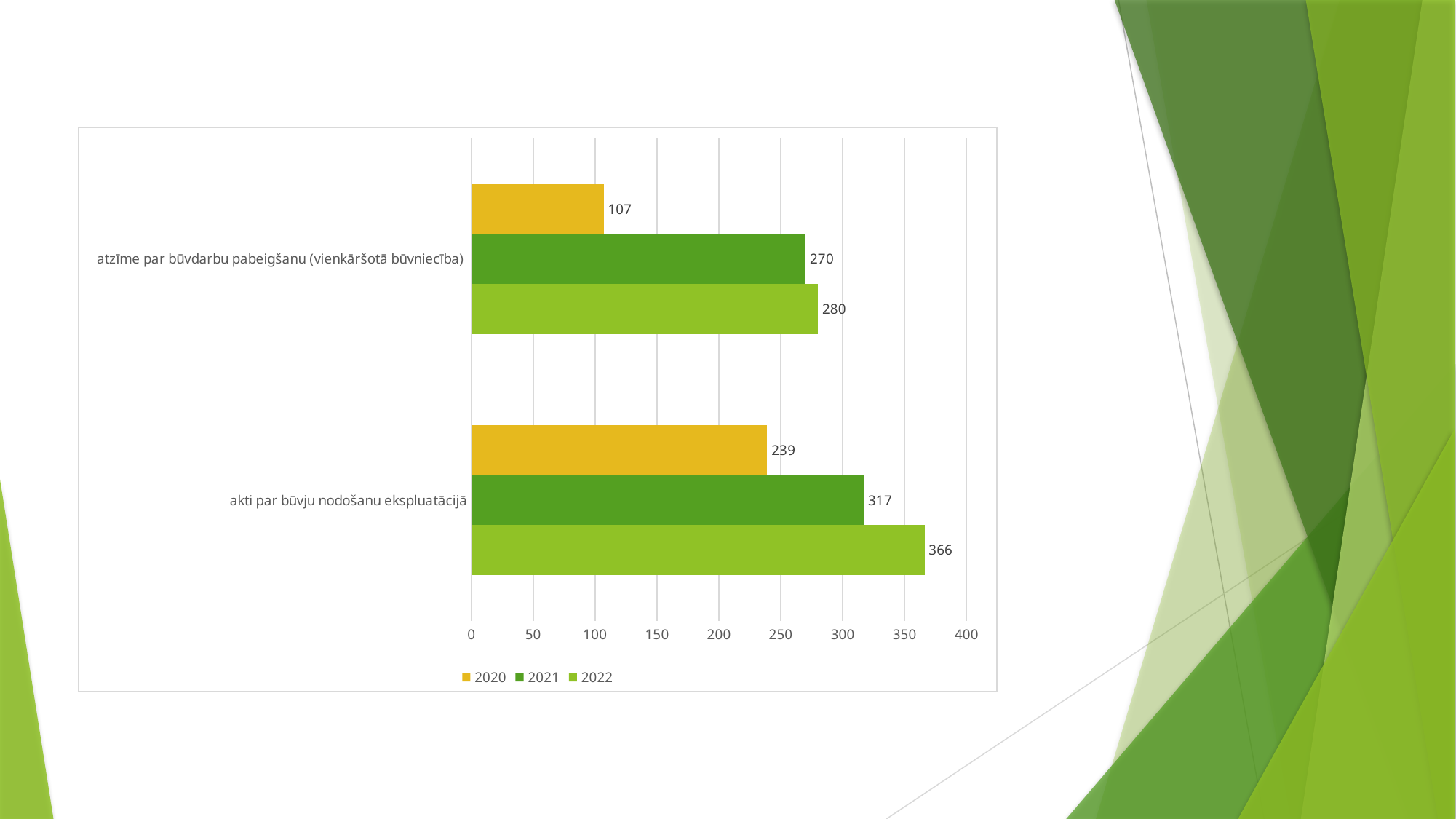
What is the difference between the 2021 and 2020 values for "atzīme par būvdarbu pabeigšanu (vienkāršotā būvniecība)"? 163 What is the difference between the 2022 and 2020 values for "akti par būvju nodošanu ekspluatācijā"? 127 Which year has the highest value for "atzīme par būvdarbu pabeigšanu (vienkāršotā būvniecība)"? 2022 How many categories are shown on the chart? 2 Which year has the lowest value for "akti par būvju nodošanu ekspluatācijā"? 2020 What is the 2021 value for "akti par būvju nodošanu ekspluatācijā"? 317 What kind of chart is shown on the slide? Bar chart What is the 2022 value for "akti par būvju nodošanu ekspluatācijā"? 366 What is the 2020 value for "atzīme par būvdarbu pabeigšanu (vienkāršotā būvniecība)"? 107 Which is larger: the 2021 value for "akti par būvju nodošanu ekspluatācijā" or the 2022 value for "atzīme par būvdarbu pabeigšanu (vienkāršotā būvniecība)"? 2021 value for akti par būvju nodošanu ekspluatācijā Which colour represents the 2020 series in the legend? Yellow How many series does the legend list? 3